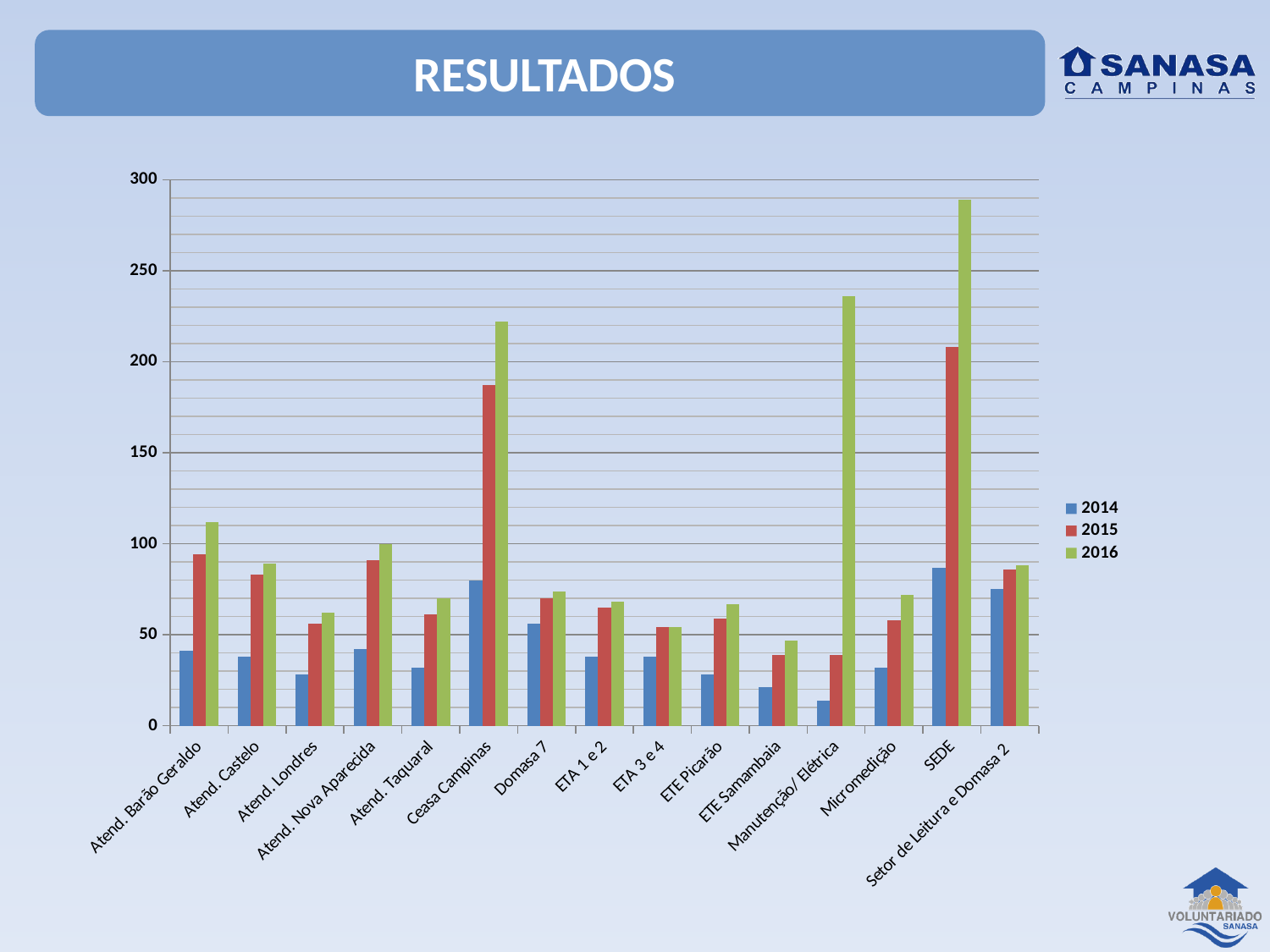
Is the 2014 value for ETE Samambaia greater or less than 50? less Is the 2016 value for SEDE greater or less than 250? greater Which is larger, the 2015 value for Atend. Castelo or the 2015 value for Atend. Londres? Atend. Castelo Which category has the lowest value for the 2014 series? Manutenção/ Elétrica Which years are listed in the chart's legend? 2014, 2015, 2016 How many series does the chart's legend list? 3 How many categories are shown along the x axis of the chart? 15 What kind of chart is shown on the slide? Bar chart Which category has the highest bar in the chart? SEDE Which category has the highest value for the 2015 series? SEDE What is the title shown above the chart? RESULTADOS Is the 2015 value for Ceasa Campinas greater or less than 150? greater